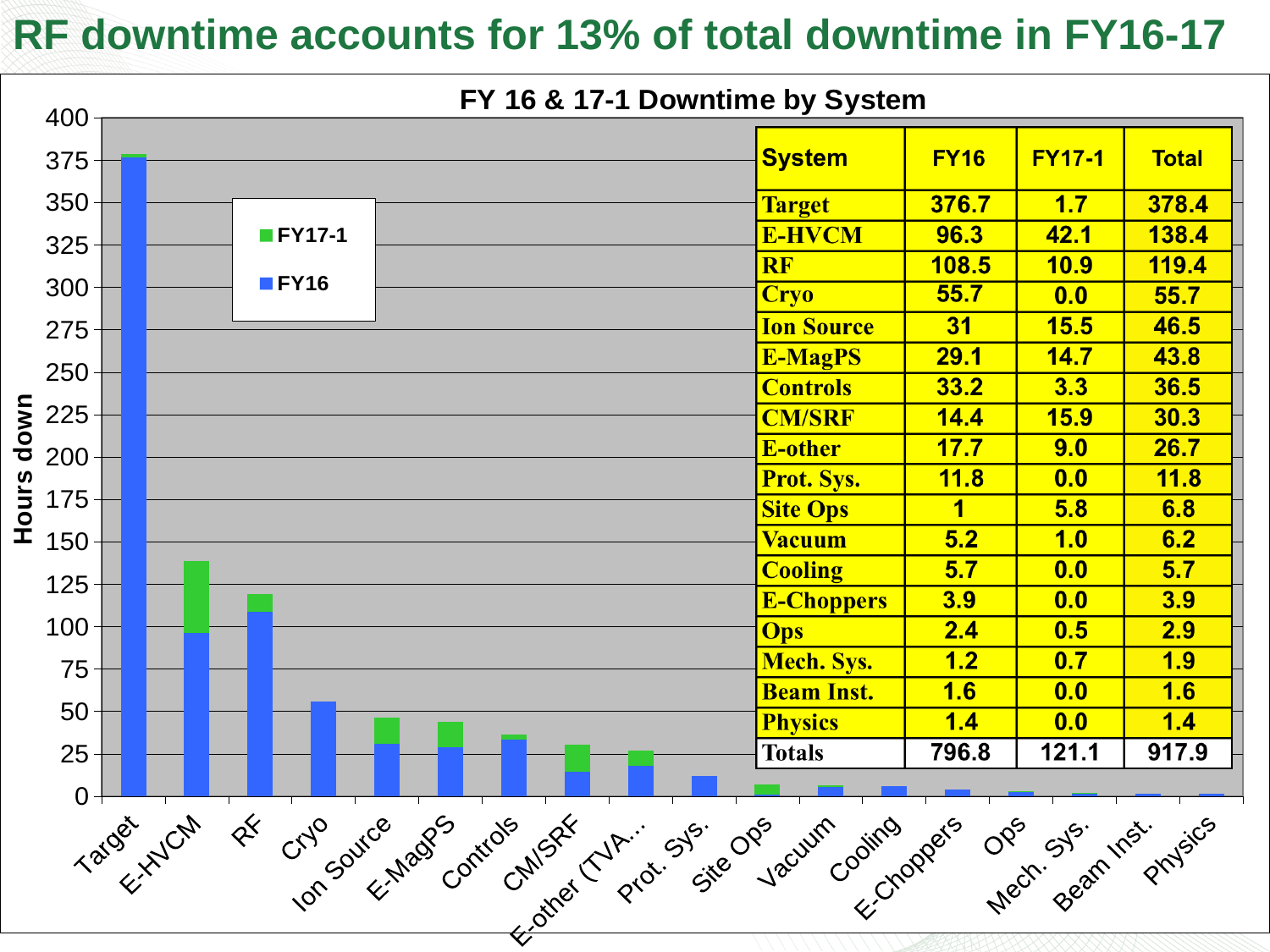
How many systems (categories) are plotted along the x axis? 18 Which has the larger total downtime, E-HVCM or RF? E-HVCM What is the FY17-1 downtime value for E-HVCM? 42.1 What kind of chart is shown on the slide? bar chart Which system has the highest total downtime? Target What is the total downtime (FY16 plus FY17-1) for Target? 378.4 Is the total downtime for Cryo greater or less than 50 hours? greater How many series does the legend list? 2 Do the total bar heights rise or fall from left to right along the x axis? fall What is the FY17-1 downtime value for Cryo? 0.0 What is the FY16 downtime value for RF? 108.5 What is the difference between the total downtime of E-HVCM and RF? 19.0